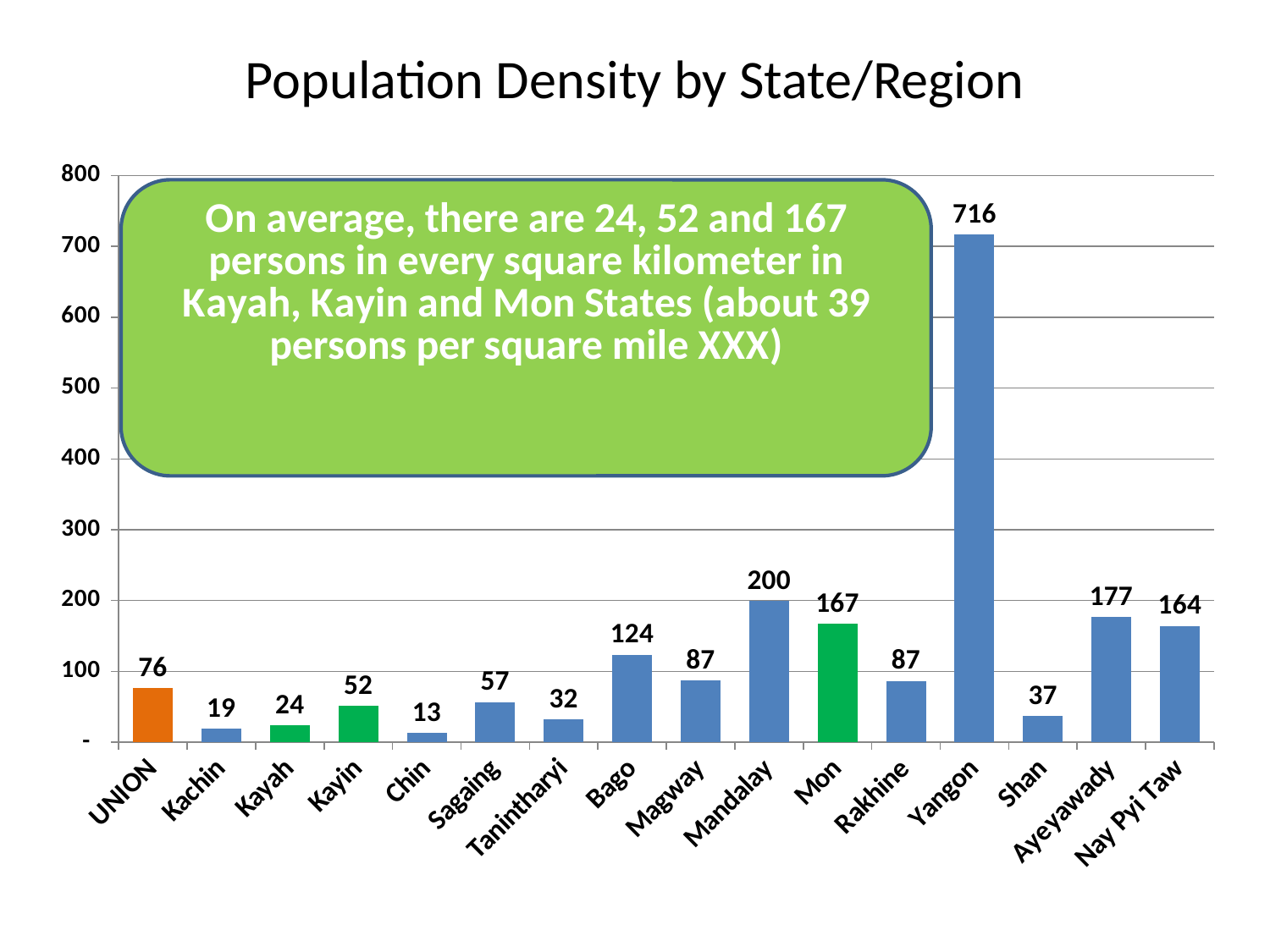
What is the difference between the population density of Ayeyawady and Nay Pyi Taw? 13 Which bar is coloured orange? UNION Is the value for Yangon greater or less than 700? greater What is the population density value shown for UNION? 76 What is the title of the chart? Population Density by State/Region How many states/regions (including UNION) are shown on the x axis? 16 What is the population density value shown for Mandalay? 200 What kind of chart is shown on the slide? bar chart Which state/region has the lowest population density on the chart? Chin Which state/region has the highest population density on the chart? Yangon What is the population density value shown for Yangon? 716 Which has a higher population density, Bago or Mon? Mon